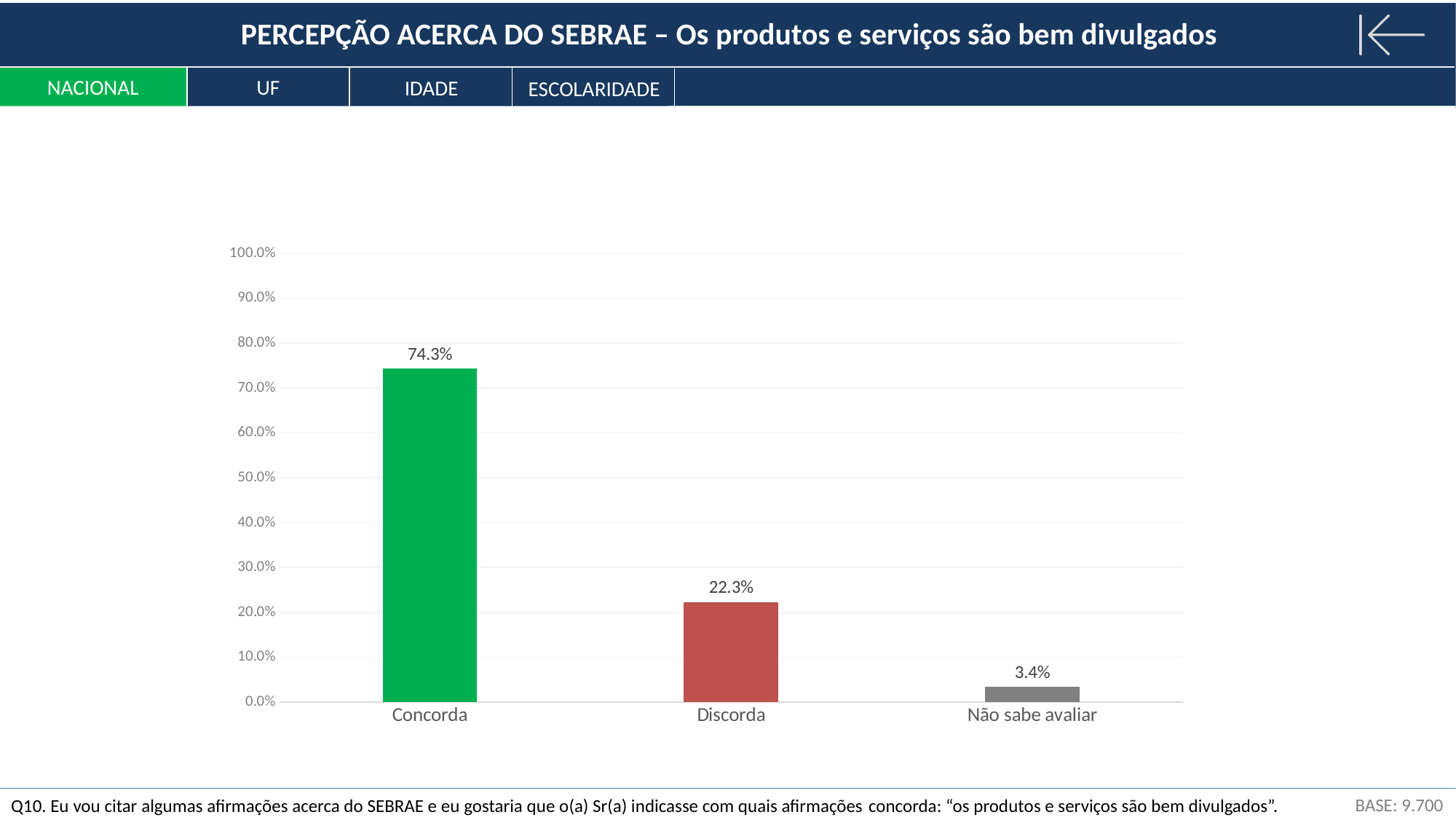
Which category has the highest value? Concorda What is the value for Discorda? 22.3% What is the difference between the values for Discorda and Não sabe avaliar? 18.9% Which is larger, the value for Discorda or the value for Não sabe avaliar? Discorda What colour is the bar for Concorda? green What is the value for Concorda? 74.3% What kind of chart is shown on the slide? bar chart How many categories are shown on the chart? 3 What is the difference between the values for Concorda and Discorda? 52.0% Is the value for Concorda greater or less than 70.0%? greater What is the value for Não sabe avaliar? 3.4% Which category has the lowest value? Não sabe avaliar